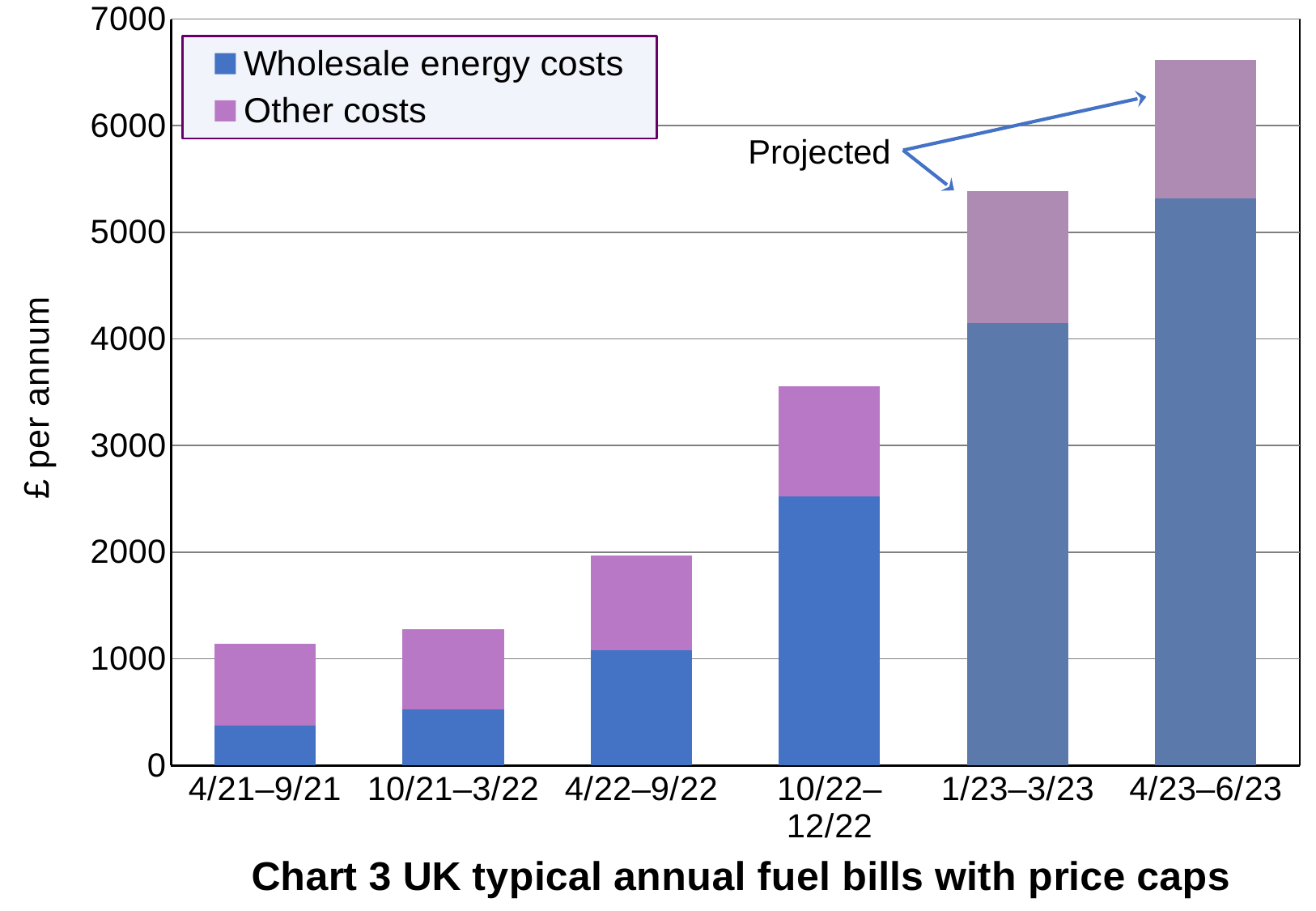
What kind of chart is shown on the slide? Stacked bar chart Is the total bar for 4/23–6/23 greater or less than 6000? greater Do the total annual fuel bills rise or fall from left to right across the periods? rise Which period has the highest total annual fuel bill? 4/23–6/23 Which has the larger total bill, 10/22–12/22 or 4/22–9/22? 10/22–12/22 How many series does the legend list? 2 Is the total bar for 1/23–3/23 greater or less than 5000? greater Is the total bar for 4/21–9/21 greater or less than 1000? greater How many time periods are shown on the x axis? 6 Which period has the lowest total annual fuel bill? 4/21–9/21 Which two periods are marked as projected? 1/23–3/23 and 4/23–6/23